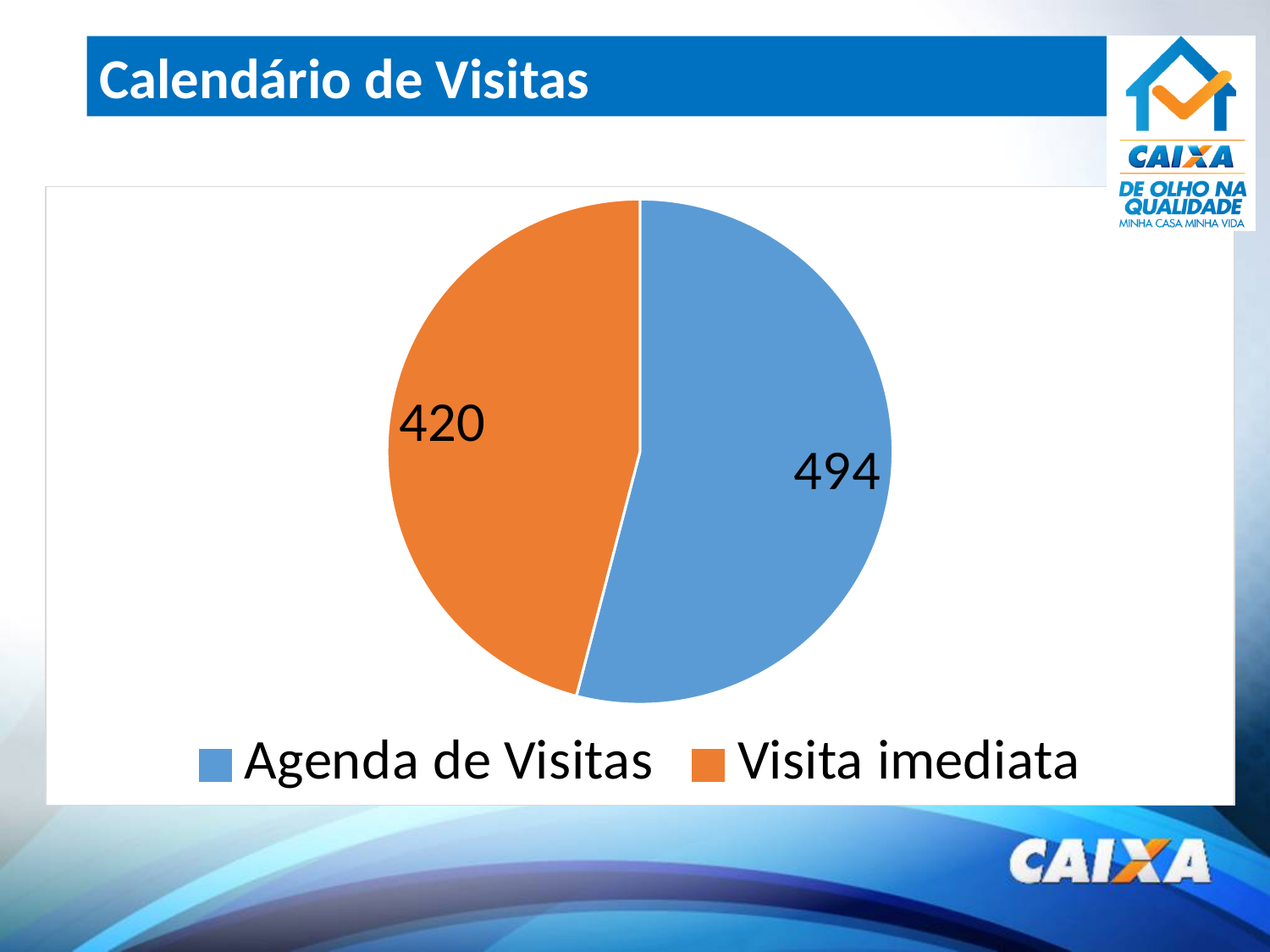
Which category has the largest slice of the pie? Agenda de Visitas What kind of chart is shown on the slide? pie chart What is the value for Visita imediata? 420 How many slices does the pie chart have? 2 How many entries does the legend list? 2 What is the total of the two slices in the pie chart? 914 Which category has the smallest slice of the pie? Visita imediata Which is larger, Agenda de Visitas or Visita imediata? Agenda de Visitas What colour is the Visita imediata slice? orange What share of the pie does Agenda de Visitas represent, to the nearest percent? 54% What is the value for Agenda de Visitas? 494 What is the difference between the values for Agenda de Visitas and Visita imediata? 74